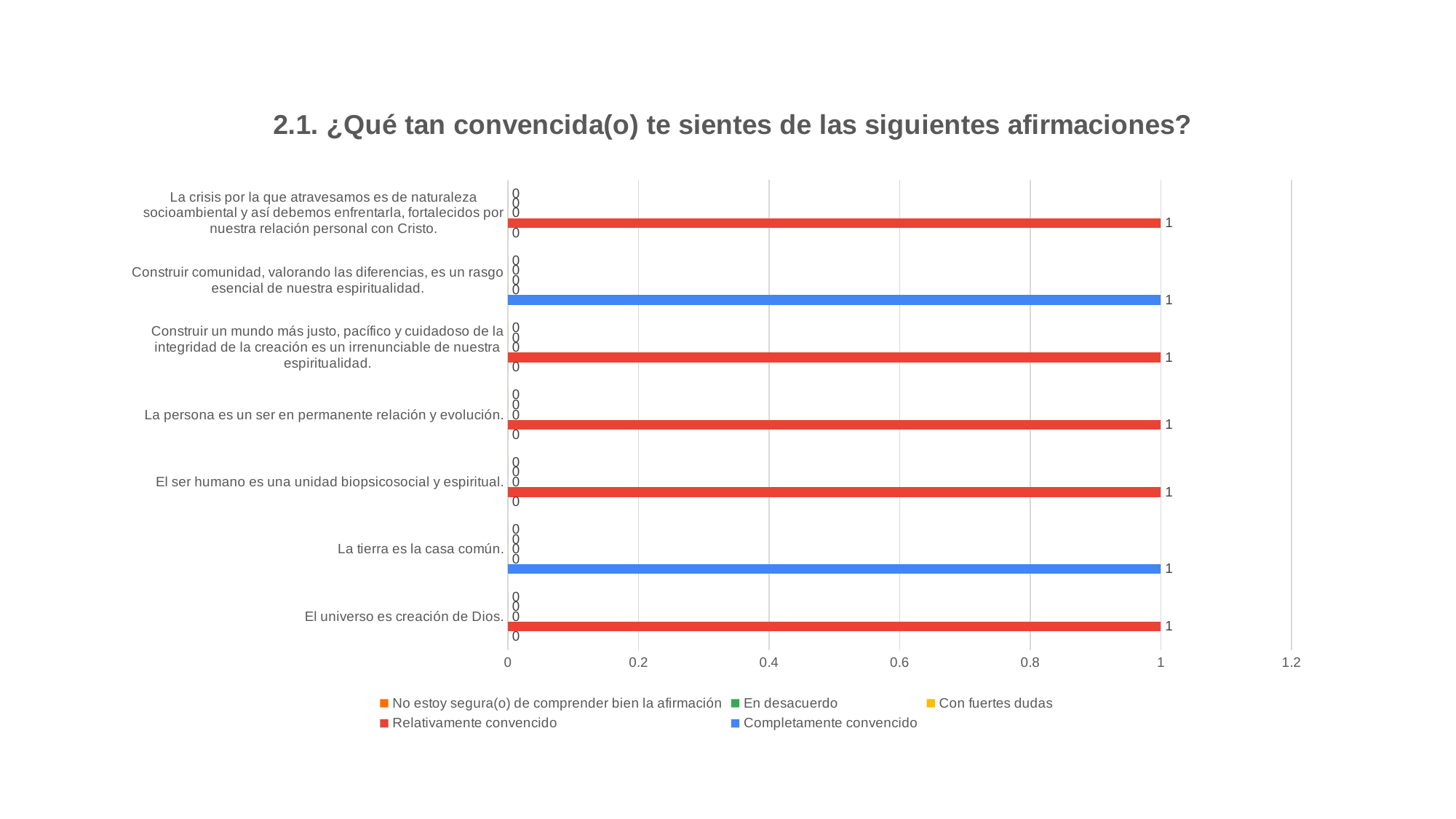
How many series does the legend list? 5 What is the value of "En desacuerdo" for "La persona es un ser en permanente relación y evolución."? 0 How many statements (categories) are listed on the chart? 7 What is the title of the chart? 2.1. ¿Qué tan convencida(o) te sientes de las siguientes afirmaciones? Which legend entry is shown in blue? Completamente convencido What is the value of "Relativamente convencido" for "El universo es creación de Dios."? 1 What is the value of "Completamente convencido" for "El universo es creación de Dios."? 0 Which series has the value 1 for "La crisis por la que atravesamos es de naturaleza socioambiental y así debemos enfrentarla, fortalecidos por nuestra relación personal con Cristo."? Relativamente convencido What is the value of "Completamente convencido" for "La tierra es la casa común."? 1 What is the value of "Relativamente convencido" for "El ser humano es una unidad biopsicosocial y espiritual."? 1 What is the value of "Completamente convencido" for "Construir comunidad, valorando las diferencias, es un rasgo esencial de nuestra espiritualidad."? 1 What kind of chart is shown on the slide? bar chart